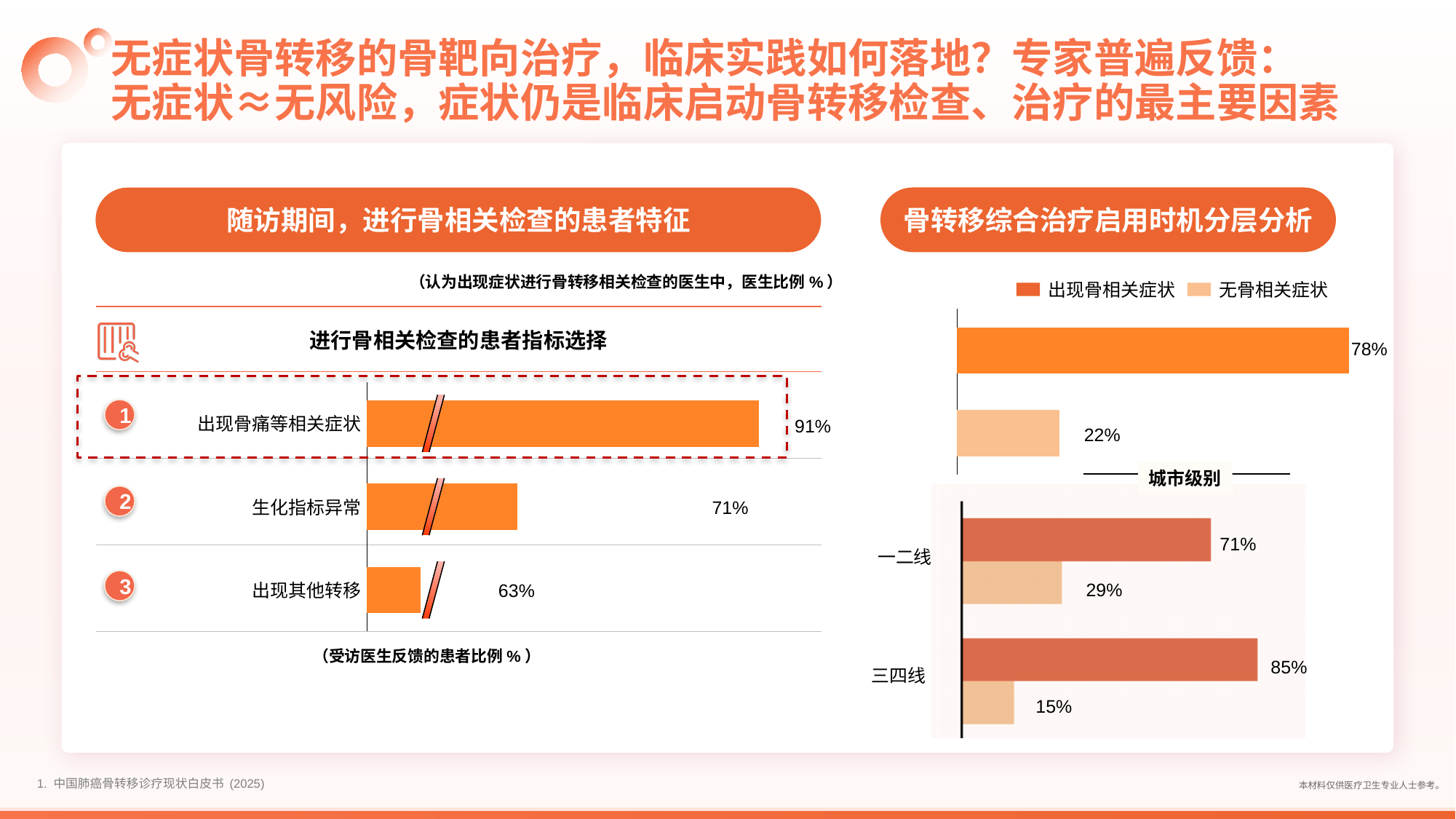
在“随访期间，进行骨相关检查的患者特征”图中，哪个指标的比例最低？ 出现其他转移 在“骨转移综合治疗启用时机分层分析”图中，“一二线”与“三四线”城市的“出现骨相关症状”比例哪个更高？ 三四线 “随访期间，进行骨相关检查的患者特征”图是什么类型的图表？ 条形图 在“随访期间，进行骨相关检查的患者特征”图中，共有多少个指标类别？ 3 在“随访期间，进行骨相关检查的患者特征”图中，“出现骨痛等相关症状”的数值是多少？ 91% 在“随访期间，进行骨相关检查的患者特征”图中，“生化指标异常”的数值是多少？ 71% 在“骨转移综合治疗启用时机分层分析”图中，“一二线”城市“出现骨相关症状”与“无骨相关症状”的比例相差多少？ 42% 在“随访期间，进行骨相关检查的患者特征”图中，“出现骨痛等相关症状”与“出现其他转移”的数值相差多少？ 28% 在“骨转移综合治疗启用时机分层分析”图中，总体“出现骨相关症状”的比例是多少？ 78% 在“骨转移综合治疗启用时机分层分析”图中，“三四线”城市“无骨相关症状”的比例是多少？ 15% 在“骨转移综合治疗启用时机分层分析”图中，图例中第二个系列的名称是什么？ 无骨相关症状 在“骨转移综合治疗启用时机分层分析”图中，图例列出了几个系列？ 2